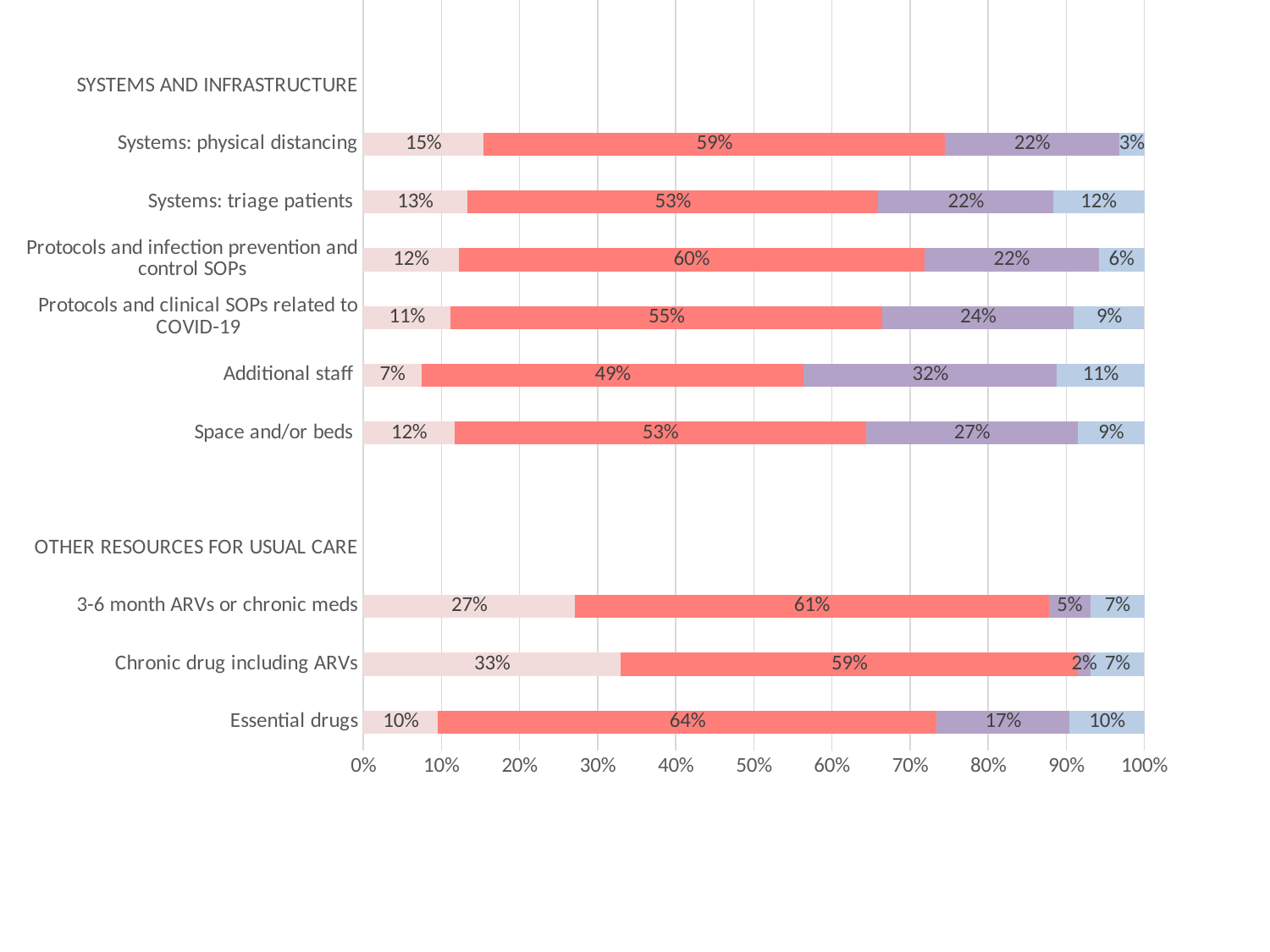
Which category has the smallest light pink (first) segment? Additional staff Which category has the largest red (second) segment? Essential drugs What is the value of the light blue (last) segment for Protocols and infection prevention and control SOPs? 6% What is the value of the purple (third) segment for 3-6 month ARVs or chronic meds? 5% What is the difference between the purple (third) segment for Additional staff and the purple segment for Space and/or beds? 5 percentage points What is the value of the red (second) segment for Essential drugs? 64% Which category has the largest purple (third) segment? Additional staff What is the maximum value shown on the x axis? 100% What is the value of the light pink (first) segment for Chronic drug including ARVs? 33% What kind of chart is shown on the slide? Stacked bar chart Which has a larger light blue (last) segment: Systems: triage patients or Systems: physical distancing? Systems: triage patients How many bars are plotted on the chart? 9